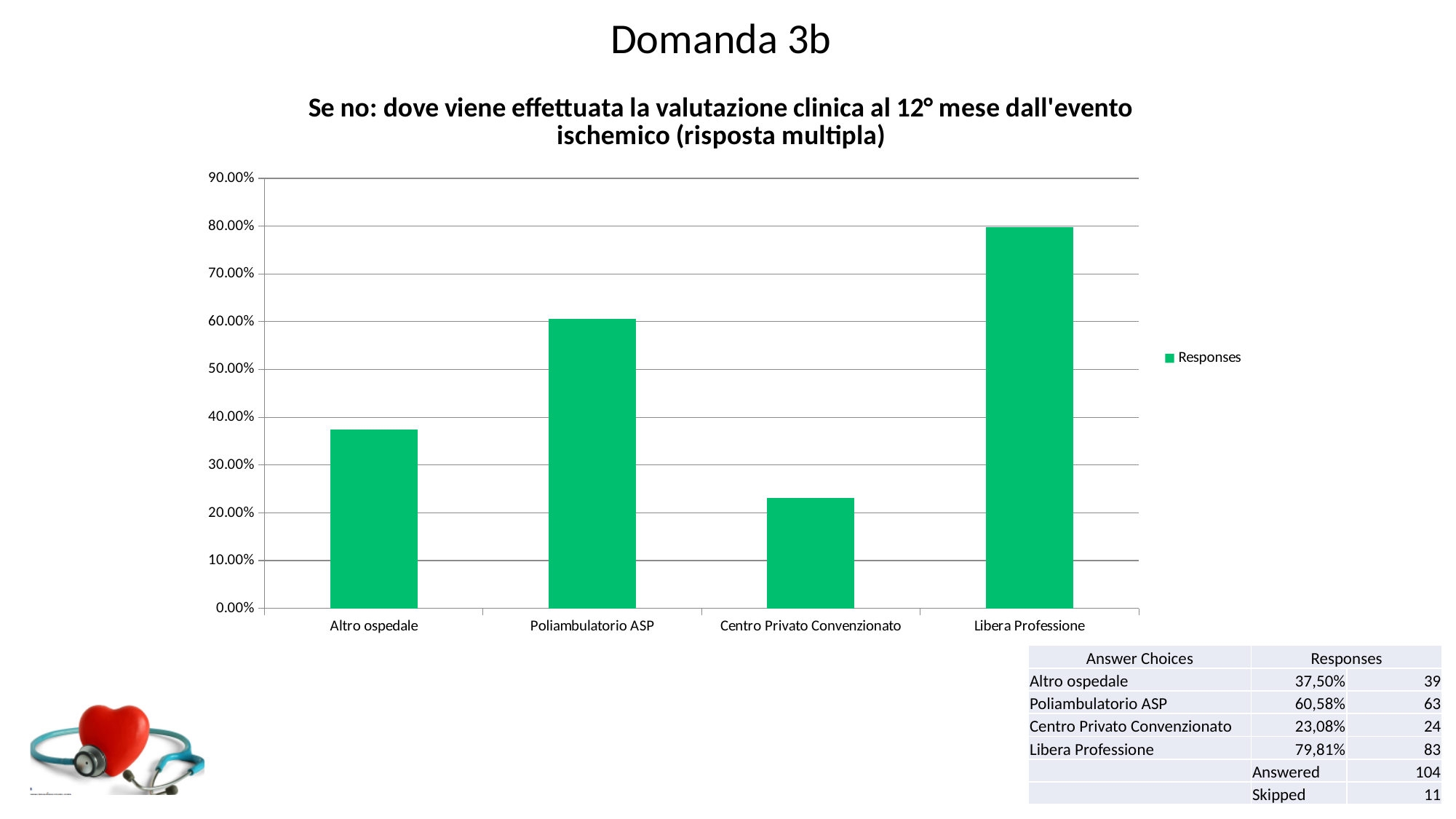
Which category has the lowest value in the chart? Centro Privato Convenzionato According to the table on the slide, how many responses did Poliambulatorio ASP receive? 63 Is the value for Poliambulatorio ASP greater or less than 50.00%? greater Which is larger, the value for Altro ospedale or the value for Poliambulatorio ASP? Poliambulatorio ASP Which category has the highest value in the chart? Libera Professione What is the name of the series shown in the chart legend? Responses How many categories are plotted on the x axis of the chart? 4 According to the table on the slide, what is the response percentage for Libera Professione? 79,81% What kind of chart is shown on the slide? bar chart How many series does the chart legend list? 1 According to the table on the slide, what is the response percentage for Altro ospedale? 37,50% Is the value for Centro Privato Convenzionato greater or less than 30.00%? less